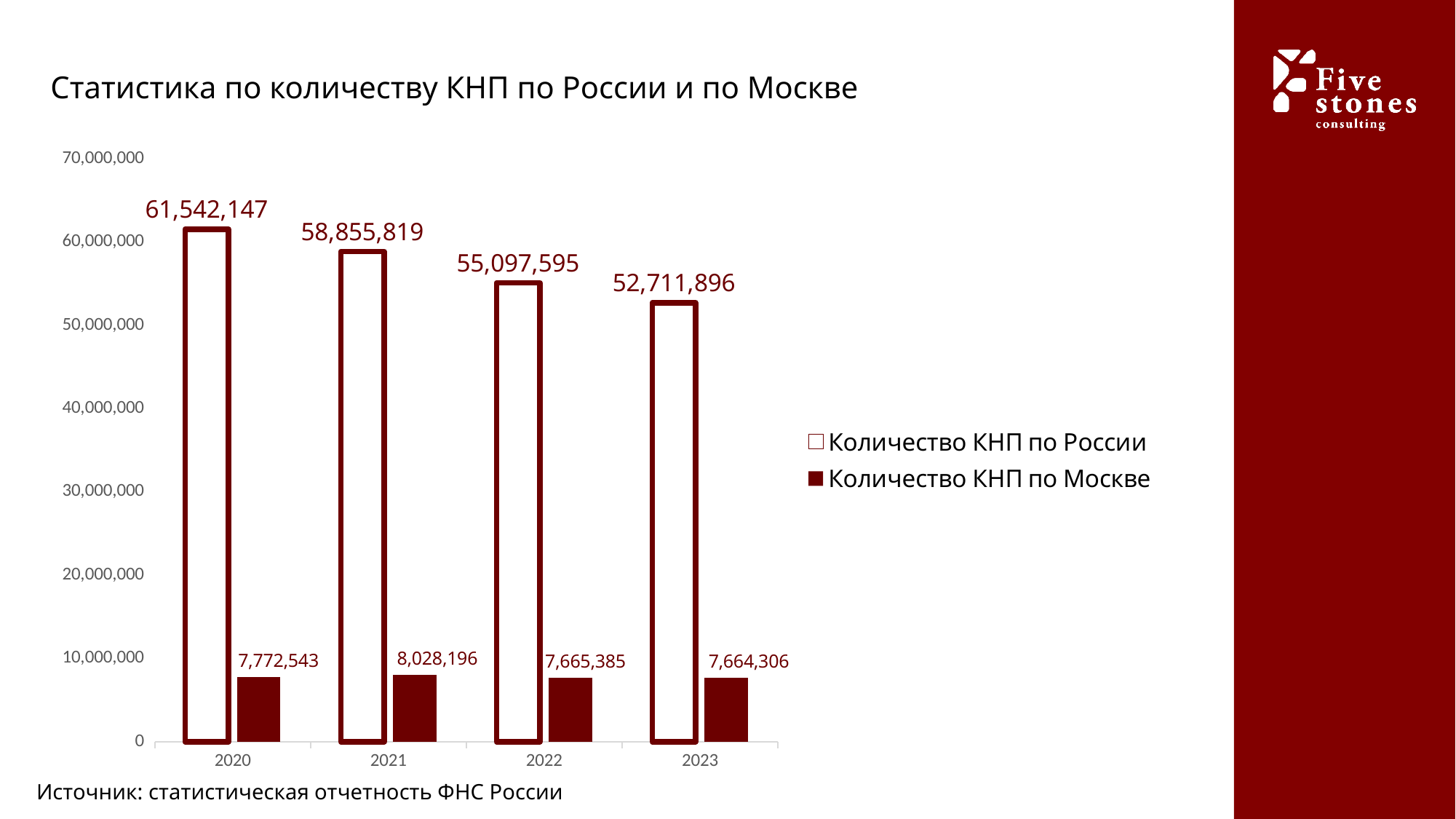
What is the difference between Количество КНП по Москве in 2021 and in 2023? 363,890 In which year is Количество КНП по России the lowest? 2023 How many series does the legend list? 2 What is the value for Количество КНП по Москве in 2021? 8,028,196 What is the difference between Количество КНП по России in 2020 and in 2023? 8,830,251 In which year is Количество КНП по России the highest? 2020 Which is larger: Количество КНП по России in 2021 or in 2022? 2021 What is the value for Количество КНП по России in 2020? 61,542,147 In which year is Количество КНП по Москве the highest? 2021 How many years are shown on the x axis? 4 What kind of chart is shown on the slide? Bar chart What is the value for Количество КНП по России in 2023? 52,711,896